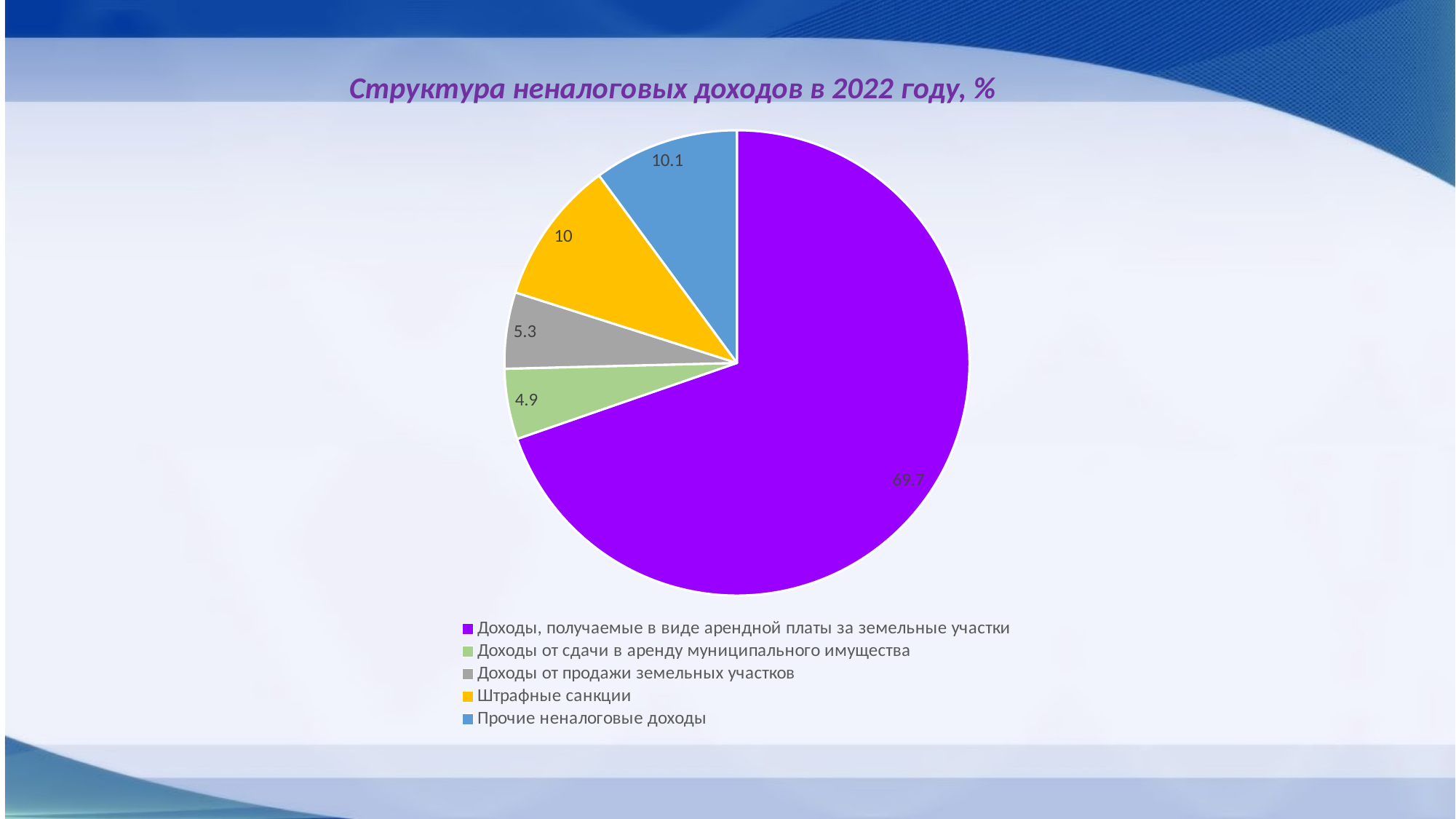
How many slices does the pie chart have? 5 What is the value for Прочие неналоговые доходы? 10.1 What colour is the slice for Штрафные санкции? yellow Which category has the largest slice of the pie? Доходы, получаемые в виде арендной платы за земельные участки What is the value for Доходы, получаемые в виде арендной платы за земельные участки? 69.7 What is the difference between the values for Прочие неналоговые доходы and Доходы от сдачи в аренду муниципального имущества? 5.2 What is the title of the chart? Структура неналоговых доходов в 2022 году, % What kind of chart is shown on the slide? pie chart Which category has the smallest slice of the pie? Доходы от сдачи в аренду муниципального имущества Which is larger: Доходы от продажи земельных участков or Доходы от сдачи в аренду муниципального имущества? Доходы от продажи земельных участков What is the value for Штрафные санкции? 10 What is the value for Доходы от продажи земельных участков? 5.3